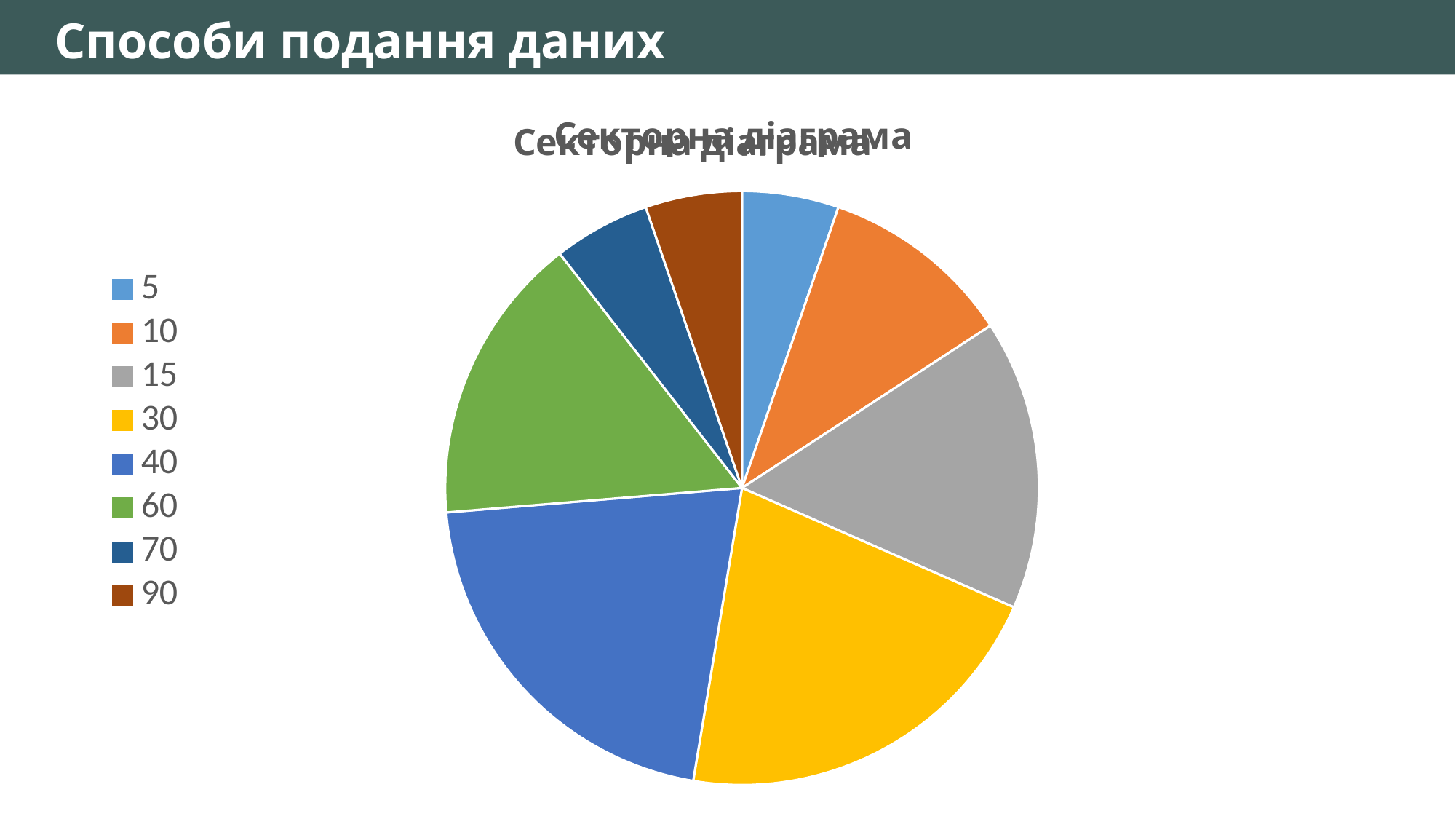
Which slice is larger in the pie chart, the one labelled "30" or the one labelled "15"? 30 What is the title of the pie chart? Секторна діаграма Which slice is larger in the pie chart, the one labelled "40" or the one labelled "70"? 40 Which slice is larger in the pie chart, the one labelled "60" or the one labelled "90"? 60 What colour is the slice labelled "30" in the pie chart? yellow What kind of chart is shown on the slide? pie chart How many entries does the legend of the pie chart list? 8 How many slices does the pie chart have? 8